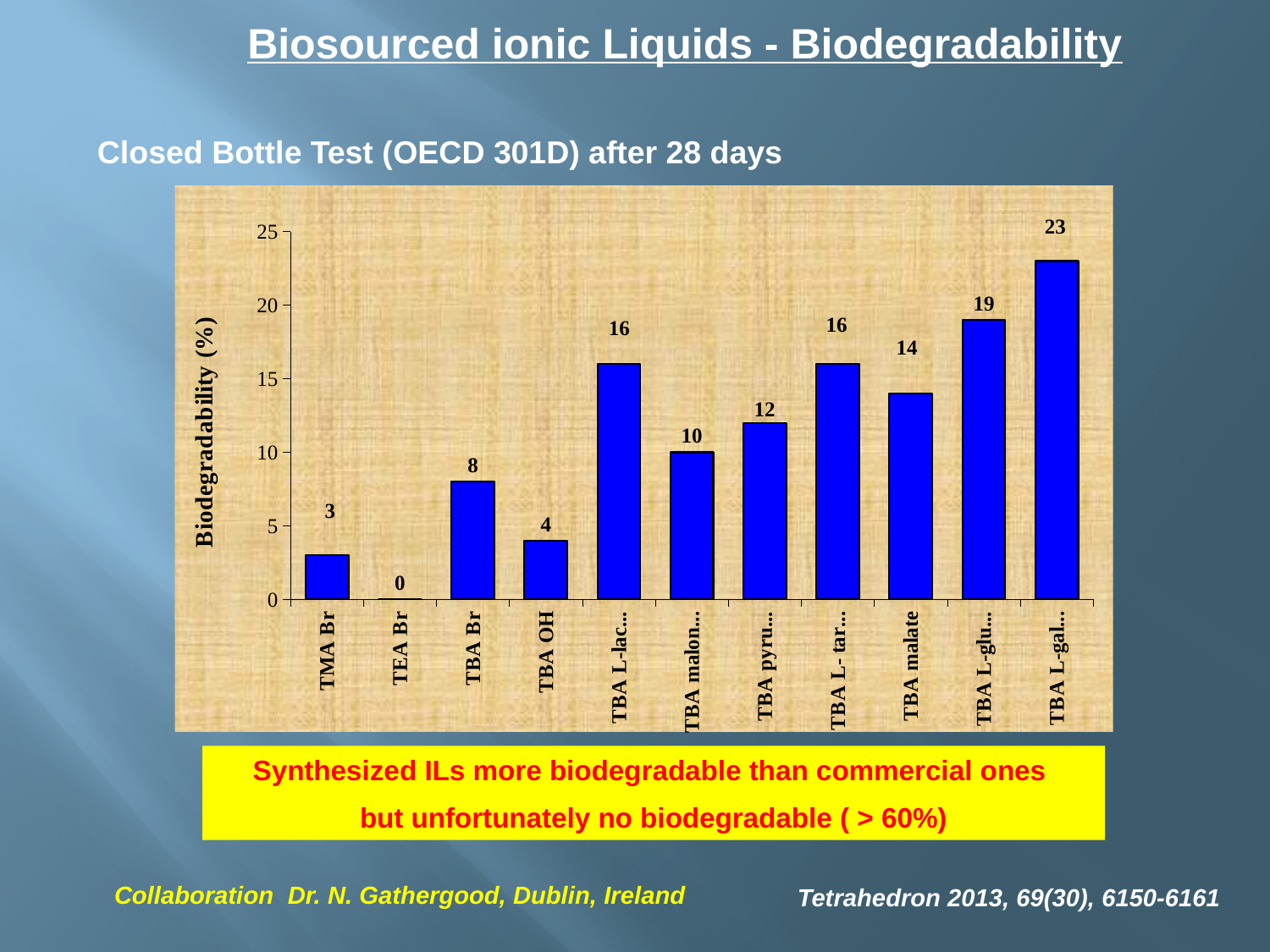
How many categories are shown on the x axis of the chart? 11 What is the biodegradability value for TBA Br? 8 What is the biodegradability value for TMA Br? 3 Which category has the lowest biodegradability? TEA Br What is the biodegradability value for TBA OH? 4 What is the biodegradability value for TBA malate? 14 What is the biodegradability value for TEA Br? 0 Which has a higher biodegradability, TBA OH or TBA Br? TBA Br Which category has the highest biodegradability? TBA L-gal... What is the label of the y axis of the chart? Biodegradability (%) What is the difference in biodegradability between TBA malate and TBA Br? 6 What type of chart is shown on the slide? bar chart